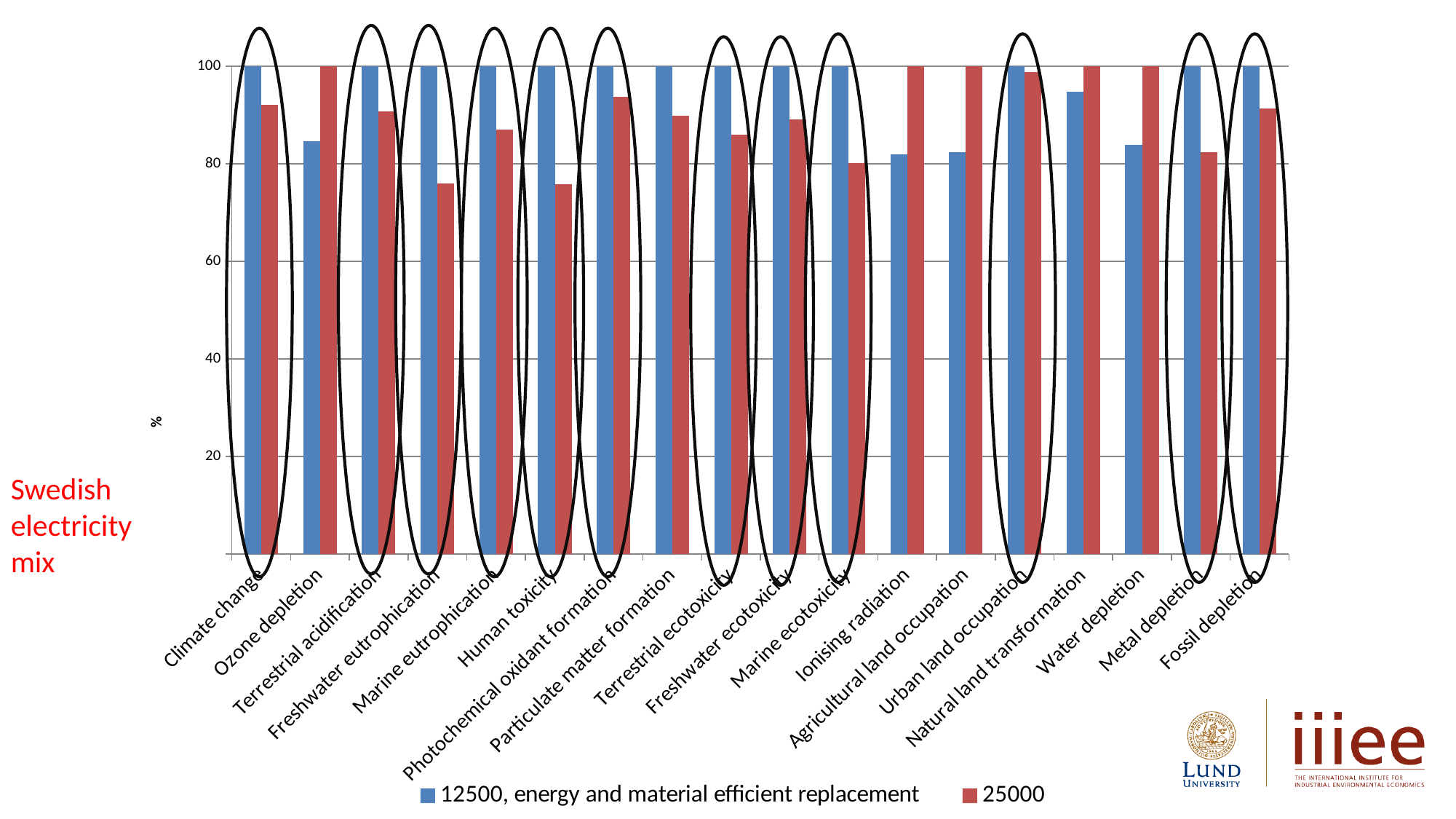
What kind of chart is shown on the slide? bar chart What is the label on the chart's y axis? % Is the value of the '25000' series for Freshwater eutrophication greater or less than 80? less How many categories are shown along the x axis of the chart? 18 For Freshwater eutrophication, which series has the larger value: '12500, energy and material efficient replacement' or '25000'? 12500, energy and material efficient replacement Is the value of the '25000' series for Human toxicity greater or less than 80? less What is the value of the '25000' series for Ozone depletion? 100 For Ozone depletion, which series has the larger value: '12500, energy and material efficient replacement' or '25000'? 25000 What is the value of the '12500, energy and material efficient replacement' series for Climate change? 100 What is the value of the '25000' series for Water depletion? 100 Is the value of the '12500, energy and material efficient replacement' series for Ozone depletion greater or less than 80? greater How many series does the chart's legend list? 2